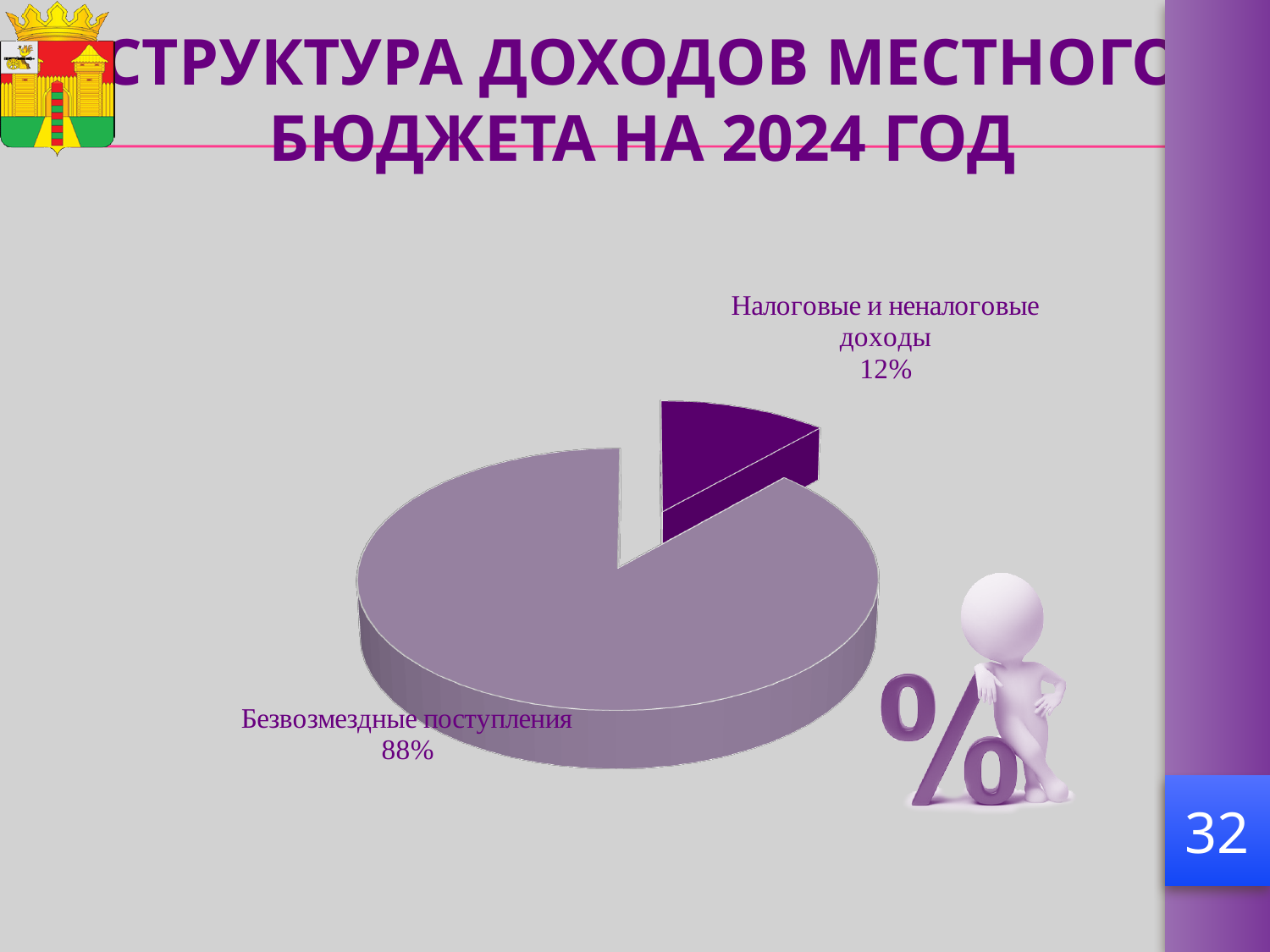
Which category has the smallest slice of the pie? Налоговые и неналоговые доходы What share of the pie does "Налоговые и неналоговые доходы" have? 12% What is the title of the slide containing the pie chart? СТРУКТУРА ДОХОДОВ МЕСТНОГО БЮДЖЕТА НА 2024 ГОД Which slice of the pie is pulled out (exploded) from the rest? Налоговые и неналоговые доходы How many slices does the pie chart have? 2 Is the share for "Налоговые и неналоговые доходы" greater or less than 50%? less What is the difference in percentage points between "Безвозмездные поступления" and "Налоговые и неналоговые доходы"? 76 percentage points What kind of chart is shown on the slide? Pie chart Which is larger: the share for "Безвозмездные поступления" or for "Налоговые и неналоговые доходы"? Безвозмездные поступления What share of the pie does "Безвозмездные поступления" have? 88% Which category has the largest slice of the pie? Безвозмездные поступления